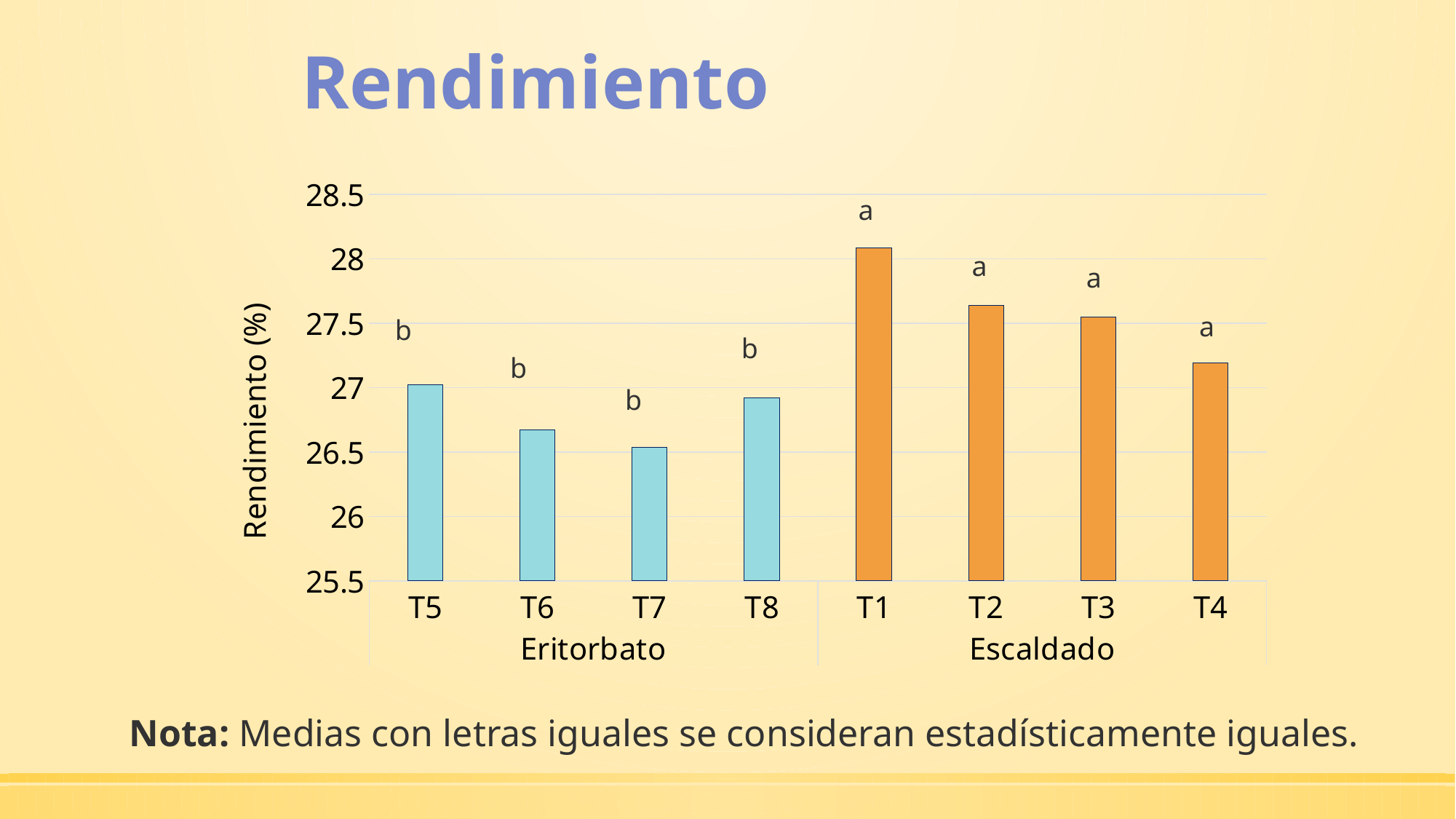
Do the values rise or fall from T1 to T4 within the Escaldado group? fall Is the value for T1 greater or less than 27.5? greater What kind of chart is shown on the slide? bar chart How many bars are plotted in the chart? 8 Is the value for T4 greater or less than 27.5? less Is the value for T6 greater or less than 27? less Which has a higher Rendimiento (%), T1 or T4? T1 Which treatment has the lowest Rendimiento (%)? T7 Which treatment has the highest Rendimiento (%)? T1 Which has a higher Rendimiento (%), T5 or T6? T5 What is the label on the vertical axis of the chart? Rendimiento (%)